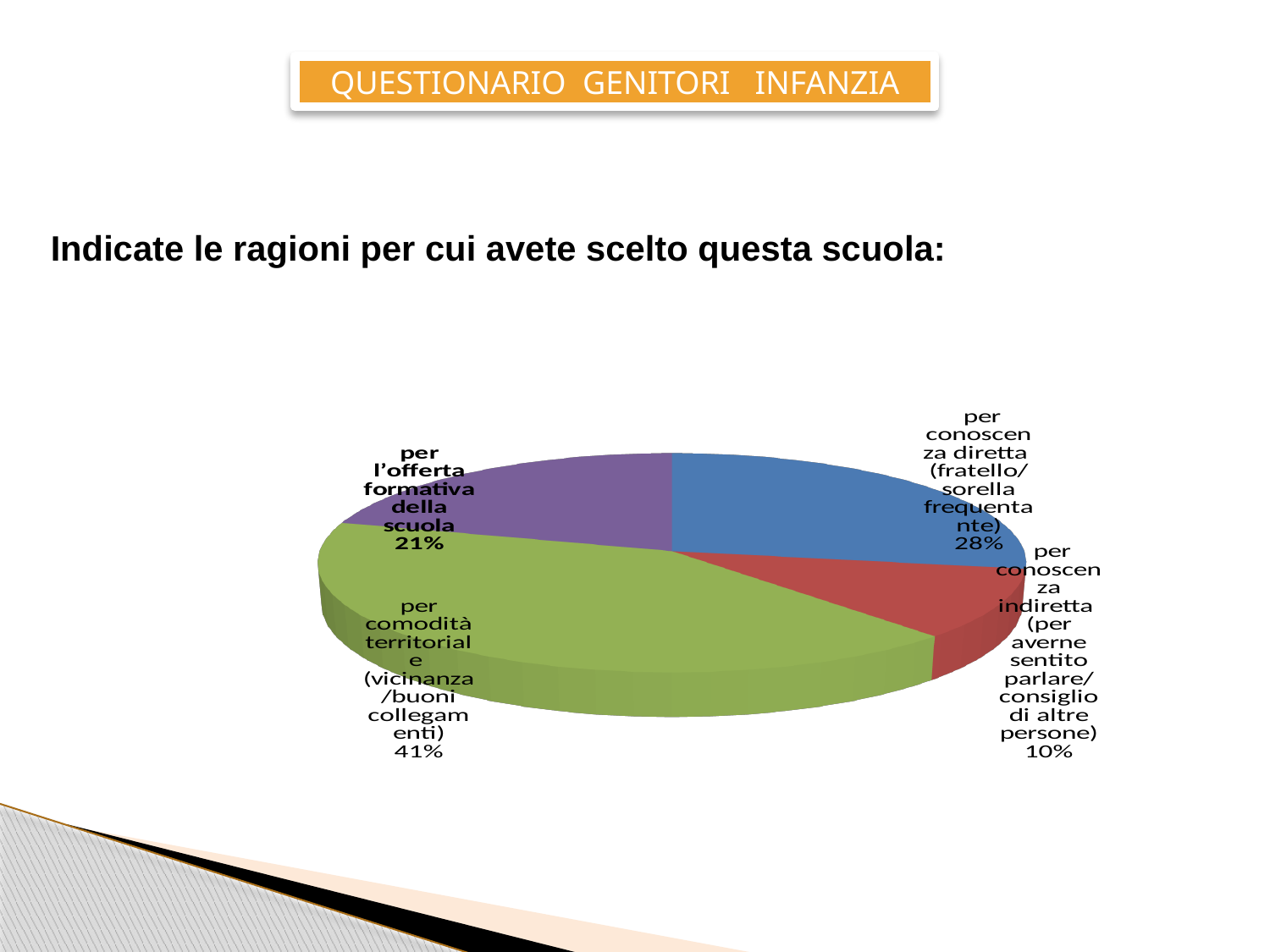
What share of the pie is labelled "per conoscenza diretta (fratello/sorella frequentante)"? 28% What colour is the slice for "per comodità territoriale (vicinanza/buoni collegamenti)"? green What share of the pie is labelled "per l'offerta formativa della scuola"? 21% Which is larger: the share for "per conoscenza diretta" or the share for "per l'offerta formativa della scuola"? per conoscenza diretta What is the difference in percentage points between "per l'offerta formativa della scuola" and "per conoscenza indiretta"? 11 What share of the pie is labelled "per conoscenza indiretta (per averne sentito parlare/consiglio di altre persone)"? 10% Which reason has the largest share of the pie? per comodità territoriale (vicinanza/buoni collegamenti) What is the difference in percentage points between "per comodità territoriale" and "per conoscenza diretta"? 13 What kind of chart is shown on the slide? pie chart Which reason has the smallest share of the pie? per conoscenza indiretta (per averne sentito parlare/consiglio di altre persone) How many slices does the pie chart have? 4